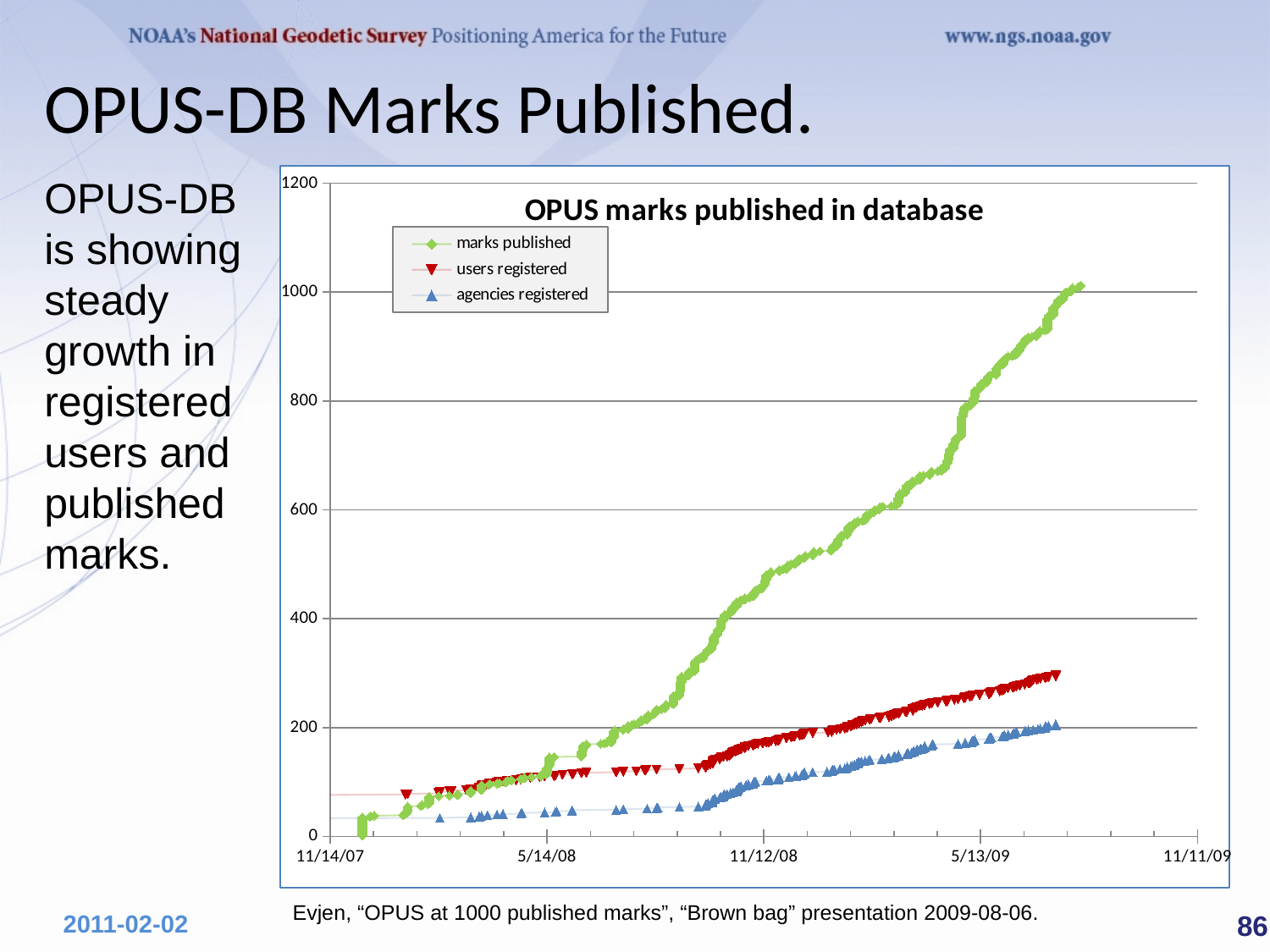
What is the maximum value shown on the vertical axis? 1200 Which series reaches the highest value at the end of the plotted period? marks published Do the values of the marks published series rise or fall over time along the x axis? rise At 5/13/09, which is larger: users registered or agencies registered? users registered Which series has the lowest values throughout the plotted period? agencies registered What is the title of the chart? OPUS marks published in database Which series is plotted in green? marks published Is the final value of the users registered series greater or less than 400? less Around 11/12/08, is the marks published series greater or less than 400? greater How many series does the chart legend list? 3